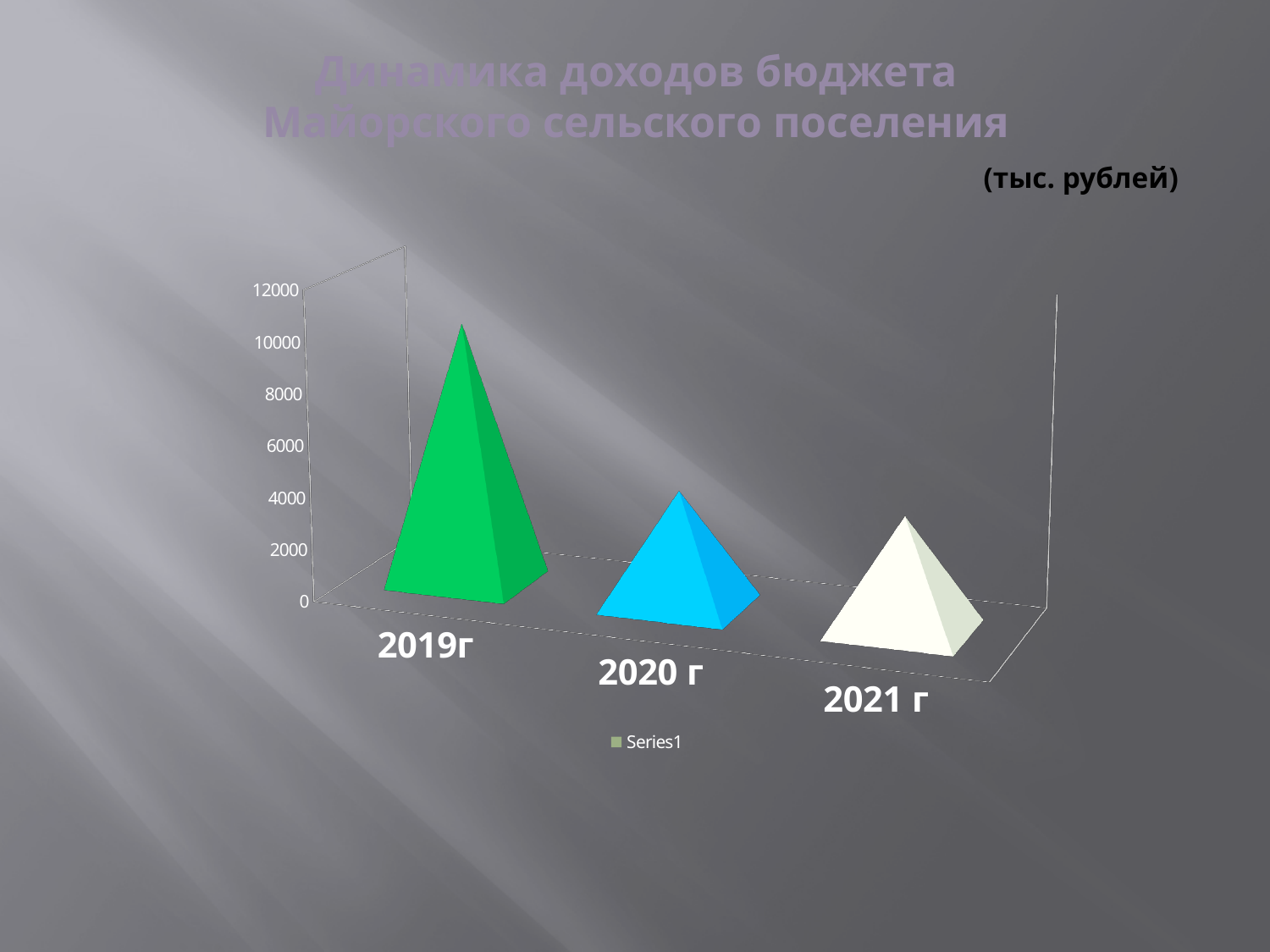
Which year has the highest value in the chart? 2019г Is the value for 2020 г greater or less than 8000? less Is the value for 2021 г greater or less than 8000? less What is the name of the series listed in the chart legend? Series1 How many categories are shown on the x axis of the chart? 3 Do the values rise or fall from 2019г to 2021 г along the x axis? fall What unit is indicated for the chart values on the slide? тыс. рублей Is the value for 2021 г greater or less than 2000? greater How many series does the chart legend list? 1 What kind of chart is shown on the slide? bar chart Which is larger, the value for 2019г or the value for 2020 г? 2019г